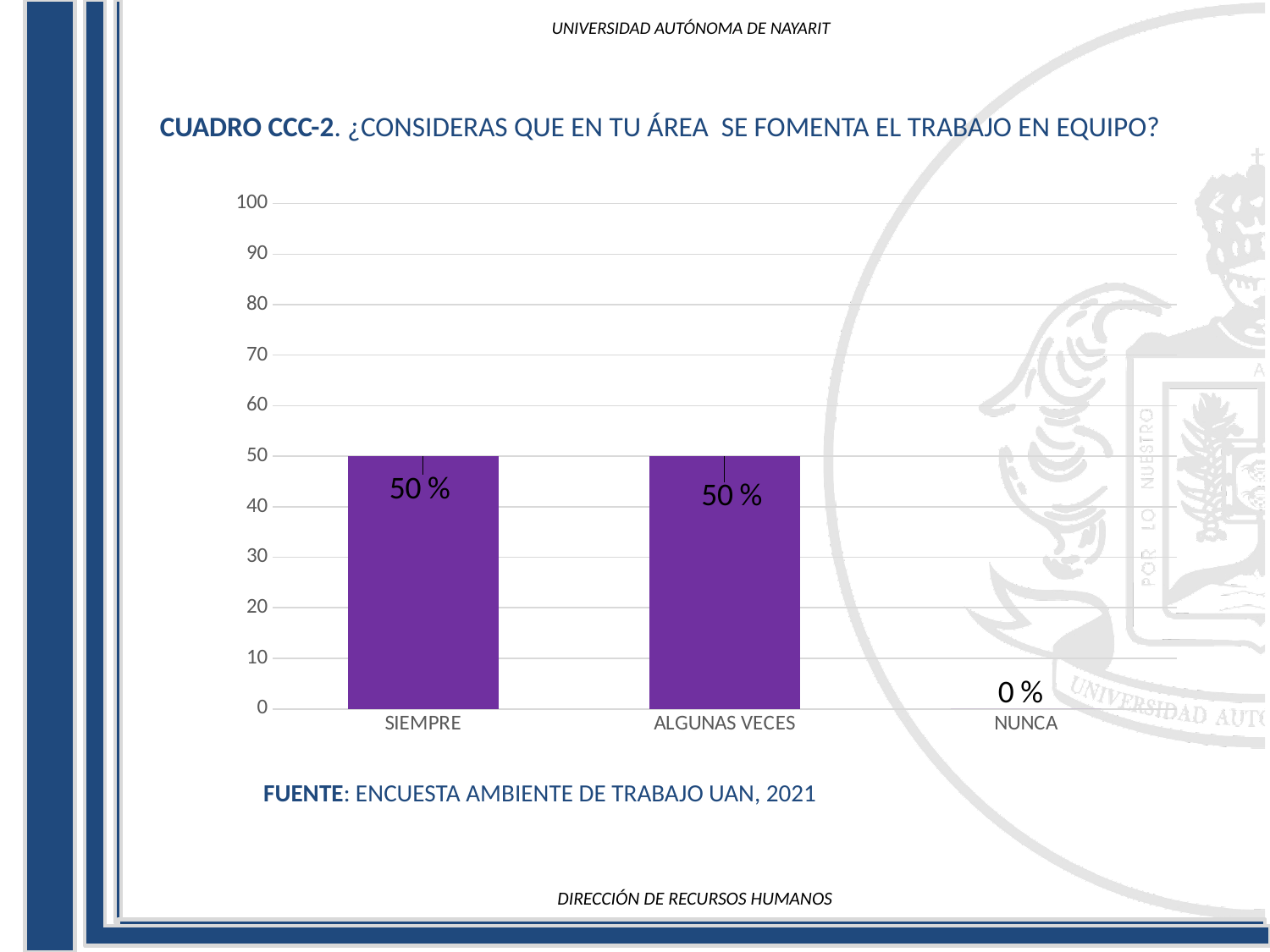
Is the value for SIEMPRE greater or less than 60? less Which is larger, the value for ALGUNAS VECES or the value for NUNCA? ALGUNAS VECES What is the difference between the values for SIEMPRE and NUNCA? 50 % What is the value for NUNCA? 0 % Which category has the lowest value? NUNCA How many categories are shown on the x axis? 3 What is the highest value shown on the vertical axis? 100 What is the source cited below the chart? ENCUESTA AMBIENTE DE TRABAJO UAN, 2021 What is the value for SIEMPRE? 50 % What kind of chart is shown on the slide? bar chart What is the value for ALGUNAS VECES? 50 %